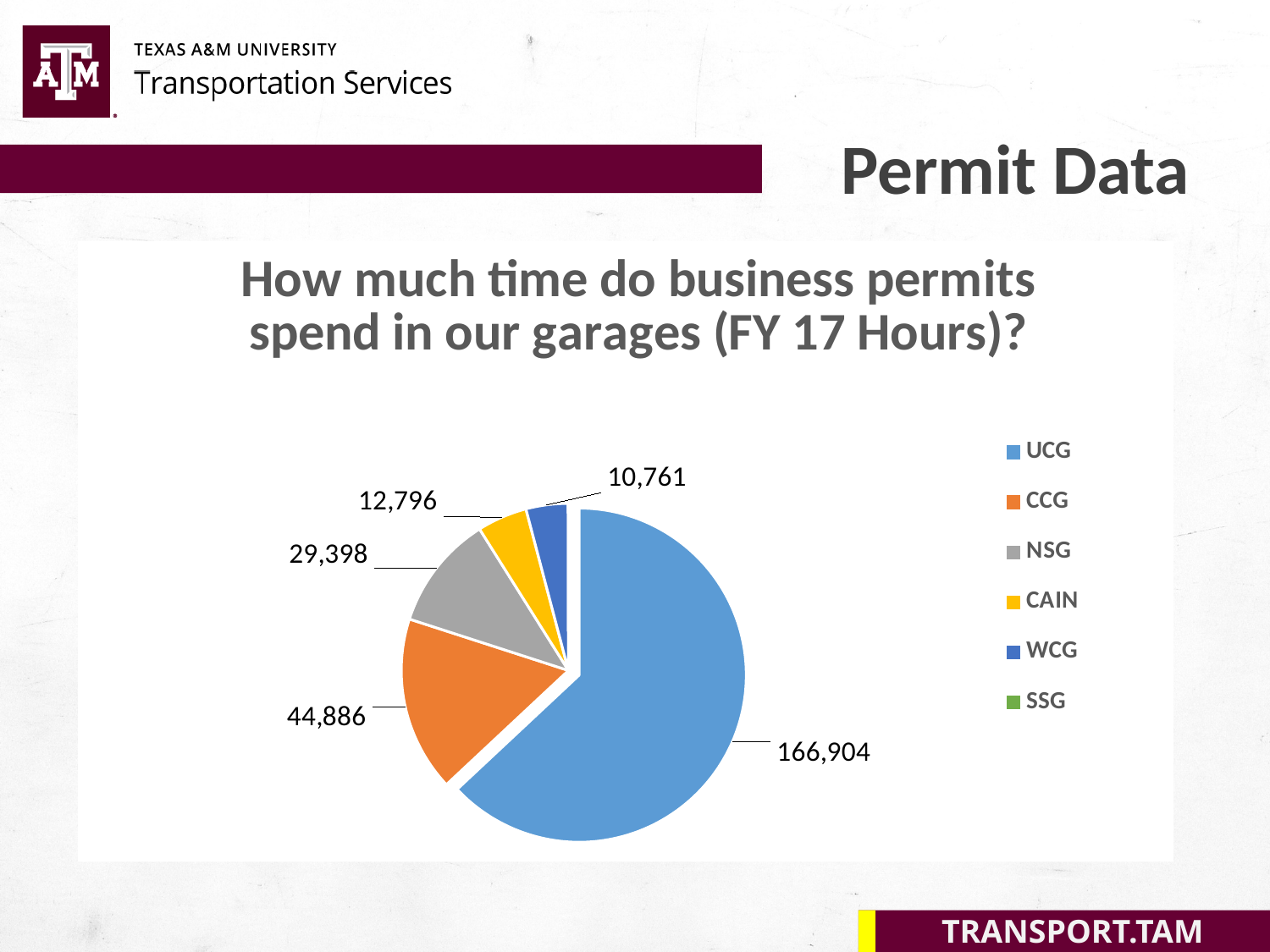
How many entries does the legend list? 6 What is the value for CCG? 44,886 What is the value for NSG? 29,398 What is the value for CAIN? 12,796 What type of chart is shown on the slide? pie chart What is the value for UCG? 166,904 Which of the labeled slices has the smallest value? WCG What is the difference between the values for CAIN and WCG? 2,035 Which garage has the largest slice of the pie? UCG Which is larger, the value for CCG or the value for NSG? CCG What is the difference between the values for UCG and CCG? 122,018 What is the value for WCG? 10,761